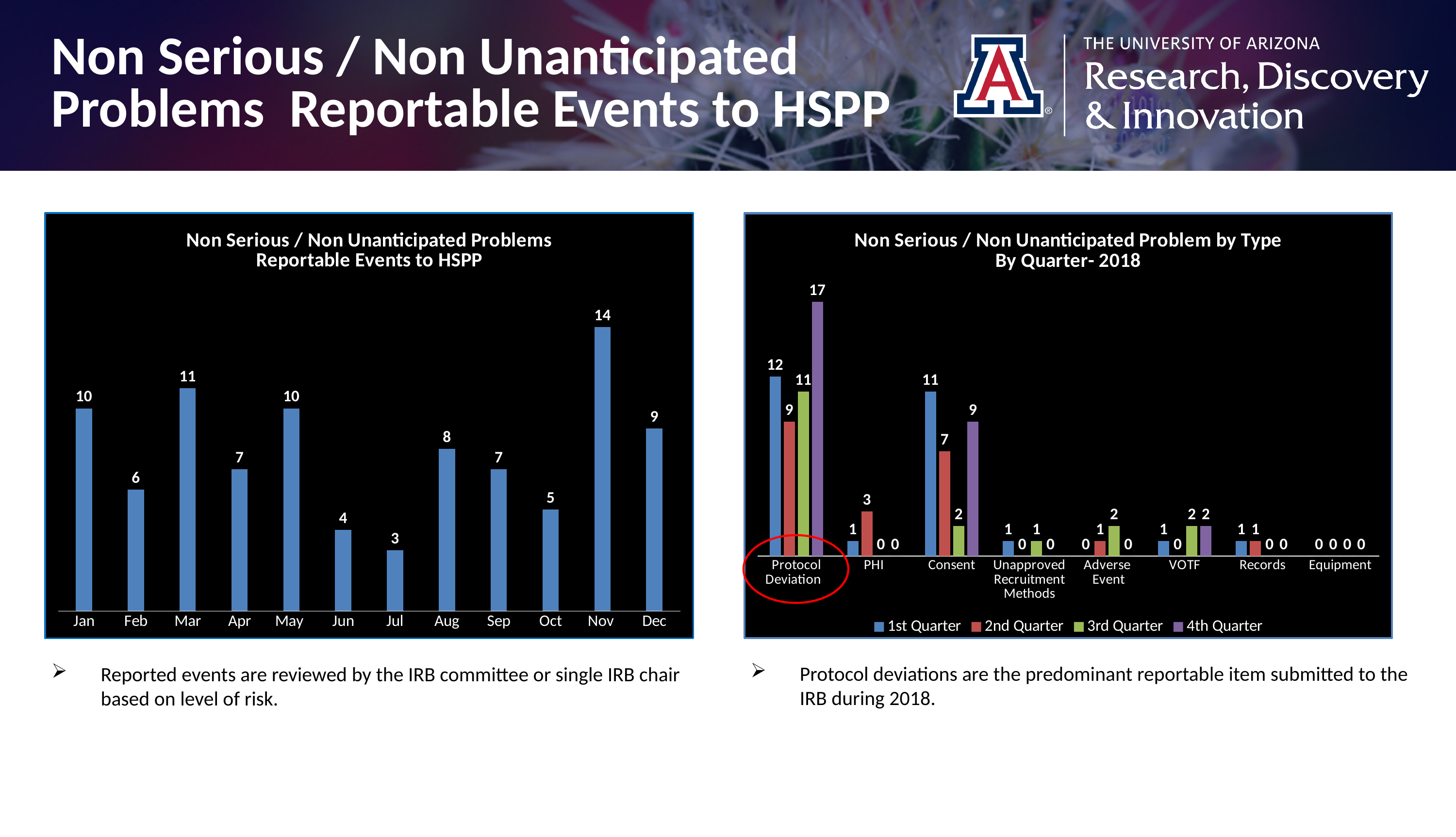
In the right chart (Non Serious / Non Unanticipated Problem by Type By Quarter- 2018), how many series does the legend list? 4 What kind of chart is the left chart (Non Serious / Non Unanticipated Problems Reportable Events to HSPP)? Bar chart In the right chart (Non Serious / Non Unanticipated Problem by Type By Quarter- 2018), what is the 2nd Quarter value for Consent? 7 In the left chart (Non Serious / Non Unanticipated Problems Reportable Events to HSPP), which month has the highest value? Nov In the left chart (Non Serious / Non Unanticipated Problems Reportable Events to HSPP), what is the value for Nov? 14 In the right chart (Non Serious / Non Unanticipated Problem by Type By Quarter- 2018), what is the difference between the 4th Quarter and 2nd Quarter values for Protocol Deviation? 8 In the left chart (Non Serious / Non Unanticipated Problems Reportable Events to HSPP), what is the difference between the values for Nov and Dec? 5 In the right chart (Non Serious / Non Unanticipated Problem by Type By Quarter- 2018), which category is circled in red? Protocol Deviation In the left chart (Non Serious / Non Unanticipated Problems Reportable Events to HSPP), which is larger, the value for Feb or the value for Apr? Apr In the left chart (Non Serious / Non Unanticipated Problems Reportable Events to HSPP), which month has the lowest value? Jul In the right chart (Non Serious / Non Unanticipated Problem by Type By Quarter- 2018), what is the 4th Quarter value for Protocol Deviation? 17 In the left chart (Non Serious / Non Unanticipated Problems Reportable Events to HSPP), how many months are shown on the x axis? 12